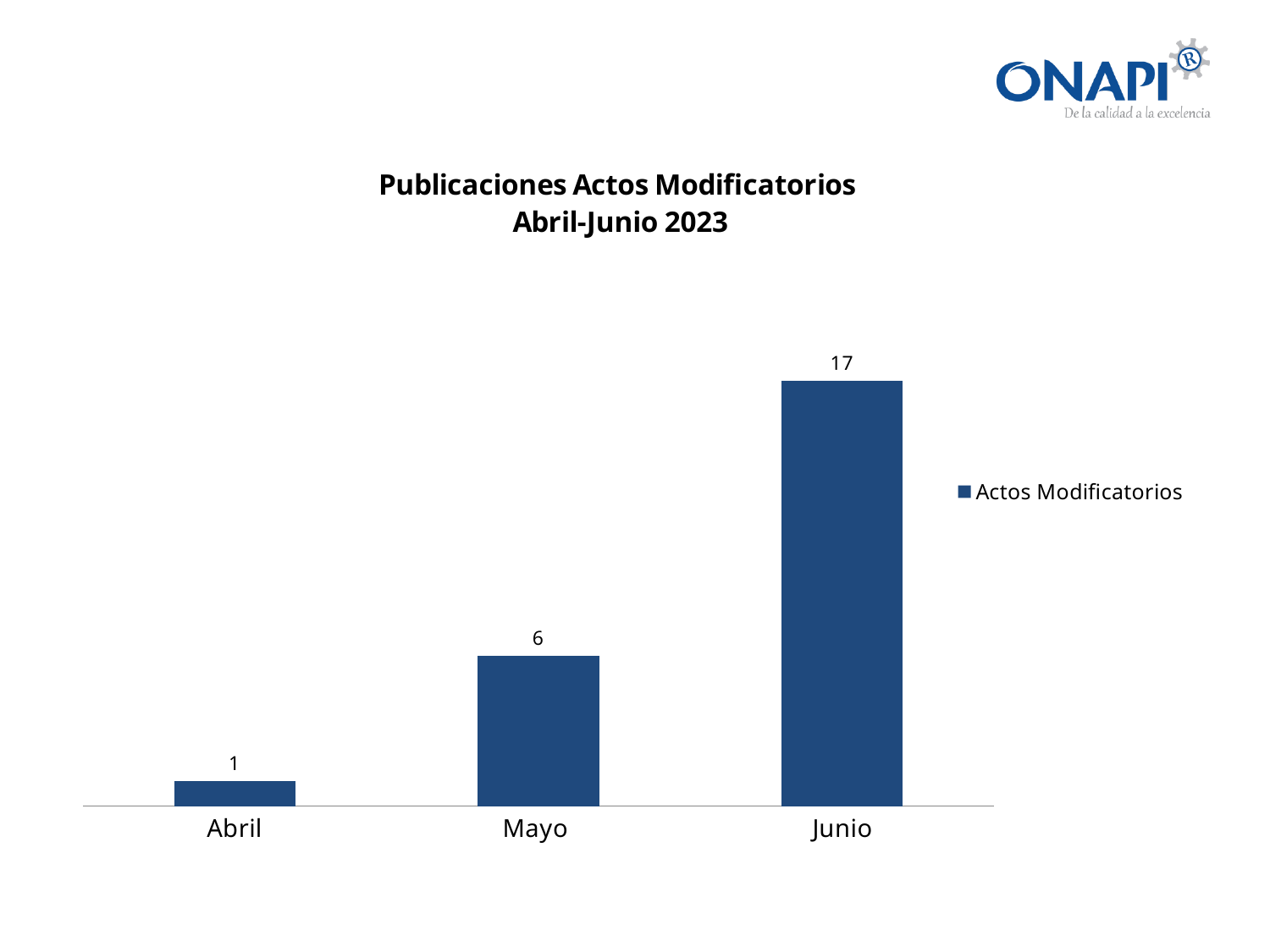
What kind of chart is shown? Bar chart How many series does the legend list? 1 What is the difference between the values for Mayo and Abril? 5 What is the value for Mayo? 6 Which month has the lowest value? Abril What is the value for Junio? 17 Do the values rise or fall from Abril to Junio? Rise What is the difference between the values for Junio and Mayo? 11 Which is larger, the value for Mayo or the value for Abril? Mayo Which month has the highest value? Junio What is the value for Abril? 1 How many months are shown on the x axis? 3